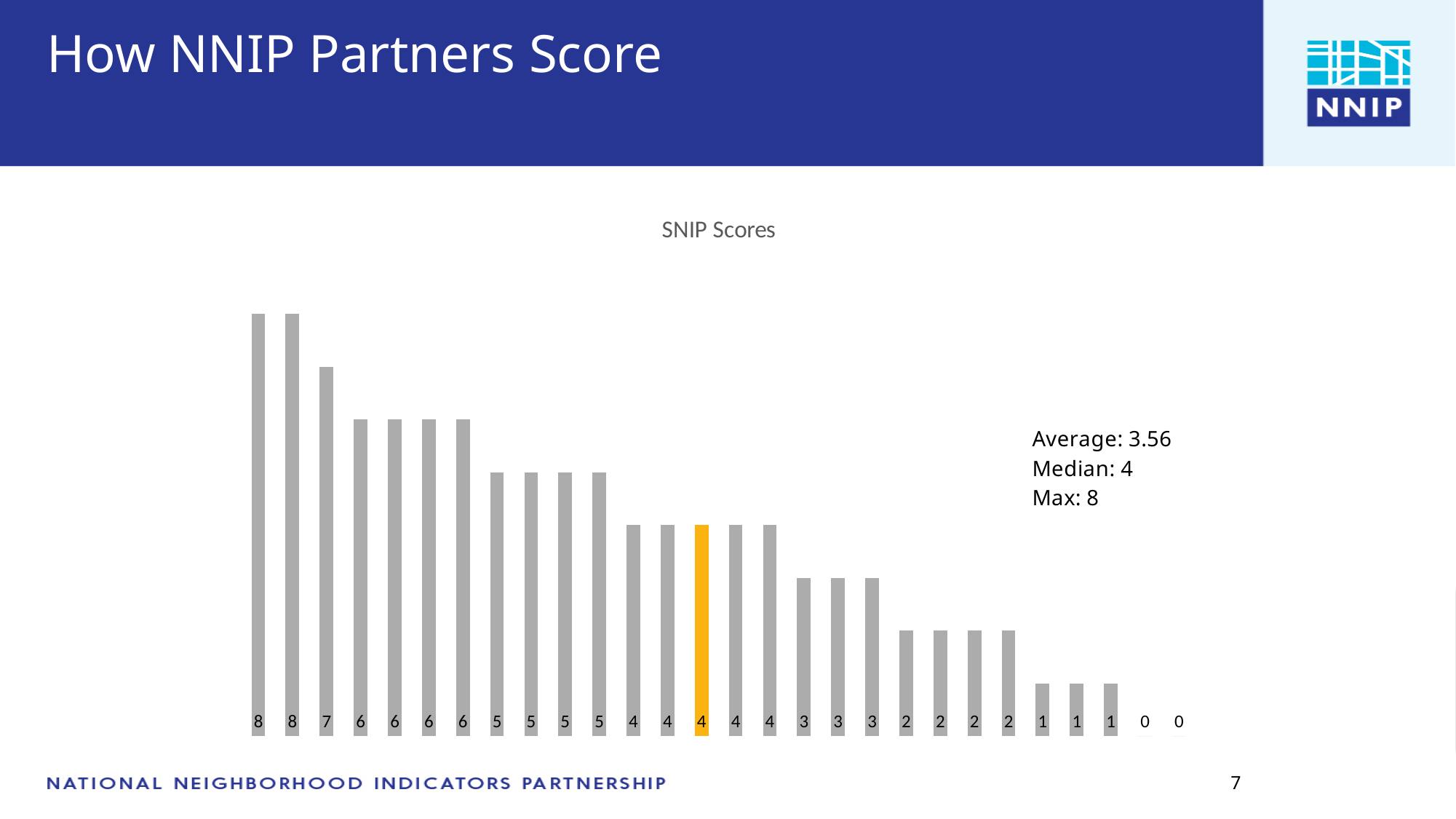
What average value is stated in the text next to the SNIP Scores chart? 3.56 What is the value of the third bar from the left in the SNIP Scores chart? 7 What is the value of the orange-highlighted bar in the SNIP Scores chart? 4 How many bars (data points) are plotted in the SNIP Scores chart? 28 How many bars in the SNIP Scores chart have a value of 4? 5 What is the title of the chart? SNIP Scores What is the value of the leftmost bar in the SNIP Scores chart? 8 What is the highest value shown in the SNIP Scores chart? 8 What is the lowest value shown in the SNIP Scores chart? 0 What is the difference between the leftmost bar and the orange-highlighted bar in the SNIP Scores chart? 4 What kind of chart is shown on the slide? bar chart Do the values in the SNIP Scores chart rise or fall from left to right? fall